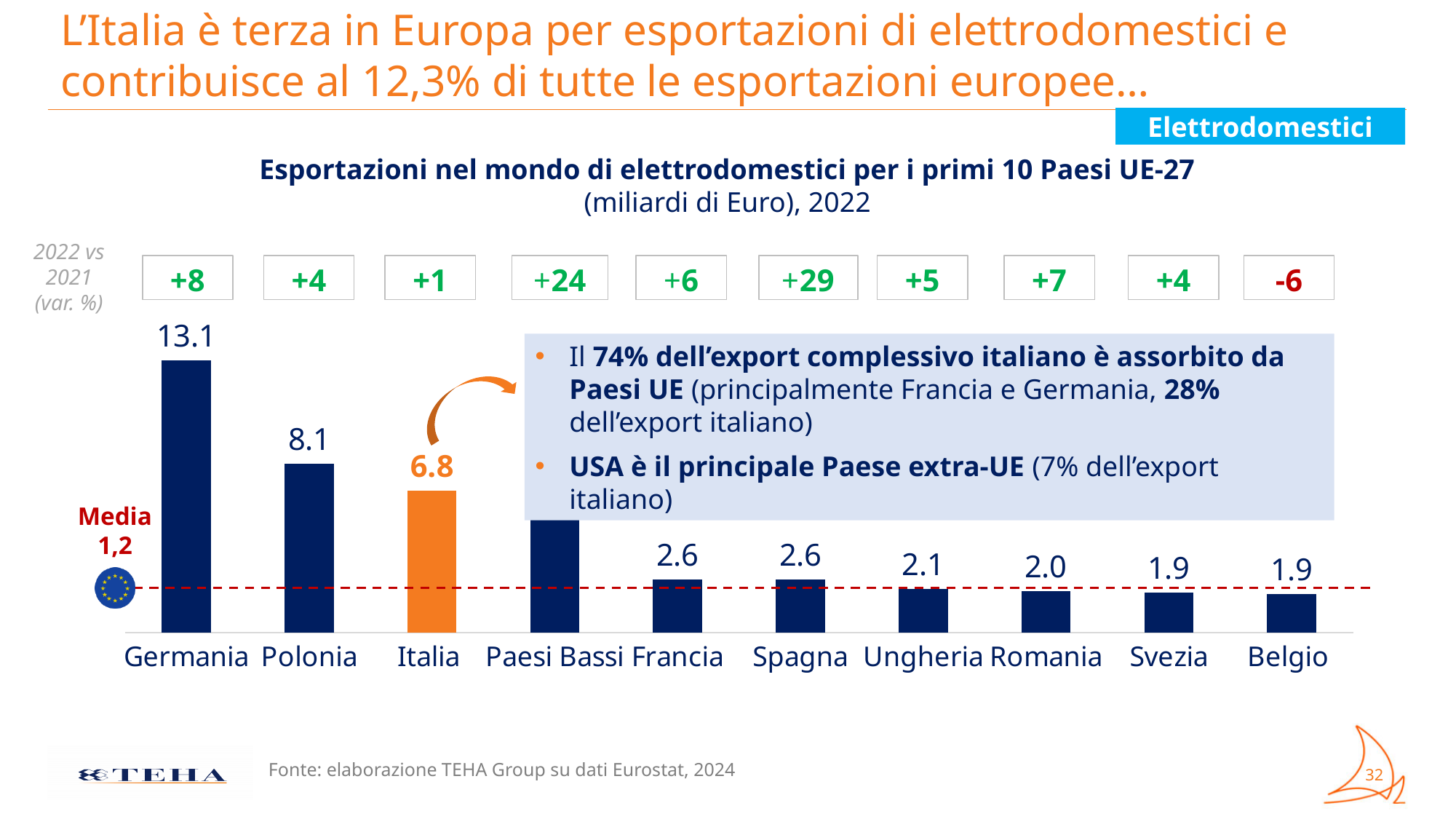
What is the export value for Italia? 6.8 Which country has the highest export value in the chart? Germania What is the value of the 'Media' (average) marked by the dashed red line? 1,2 What is the difference between the export values of Italia and Francia? 4.2 What is the 2022 vs 2021 percentage variation shown for Spagna? +29 What kind of chart is shown on the slide? bar chart Which has a larger export value, Polonia or Italia? Polonia How many countries are shown in the chart? 10 Which country shows the lowest 2022 vs 2021 percentage variation? Belgio What is the difference between the export values of Germania and Polonia? 5.0 What is the export value for Germania? 13.1 Do the export values rise or fall from left to right along the x axis? fall